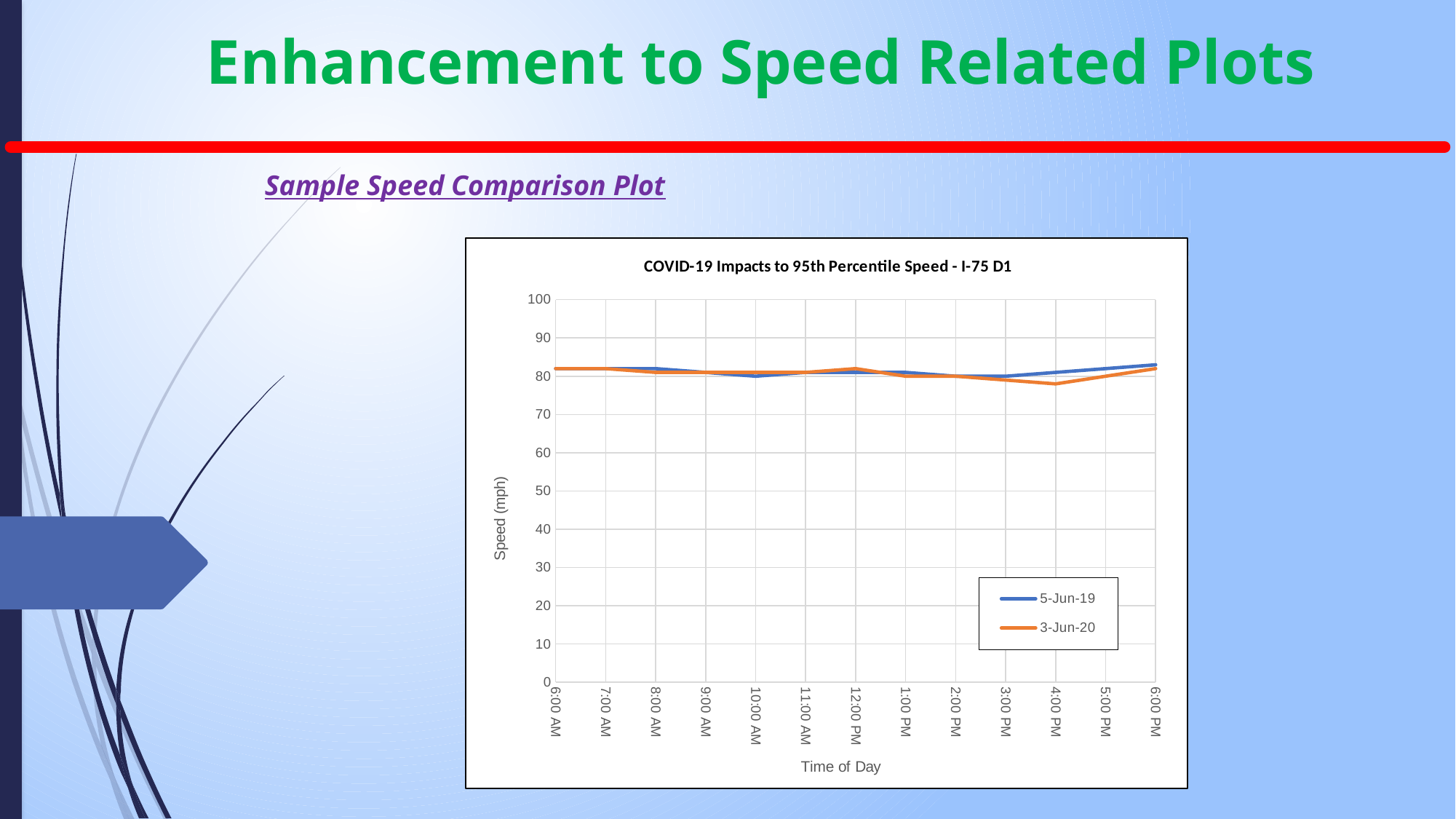
Which series is drawn in orange? 3-Jun-20 What kind of chart is shown on the slide? line chart How many time-of-day points are plotted along the x axis? 13 At 4:00 PM, which series has the higher speed, 5-Jun-19 or 3-Jun-20? 5-Jun-19 Is the 5-Jun-19 value at 6:00 PM greater or less than 90? less Is the 3-Jun-20 value at 12:00 PM greater or less than 70? greater Is the 3-Jun-20 value at 4:00 PM greater or less than 90? less What is the title of the chart? COVID-19 Impacts to 95th Percentile Speed - I-75 D1 At which time of day does the 3-Jun-20 series reach its lowest speed? 4:00 PM What is the label of the y axis? Speed (mph) How many series does the chart legend list? 2